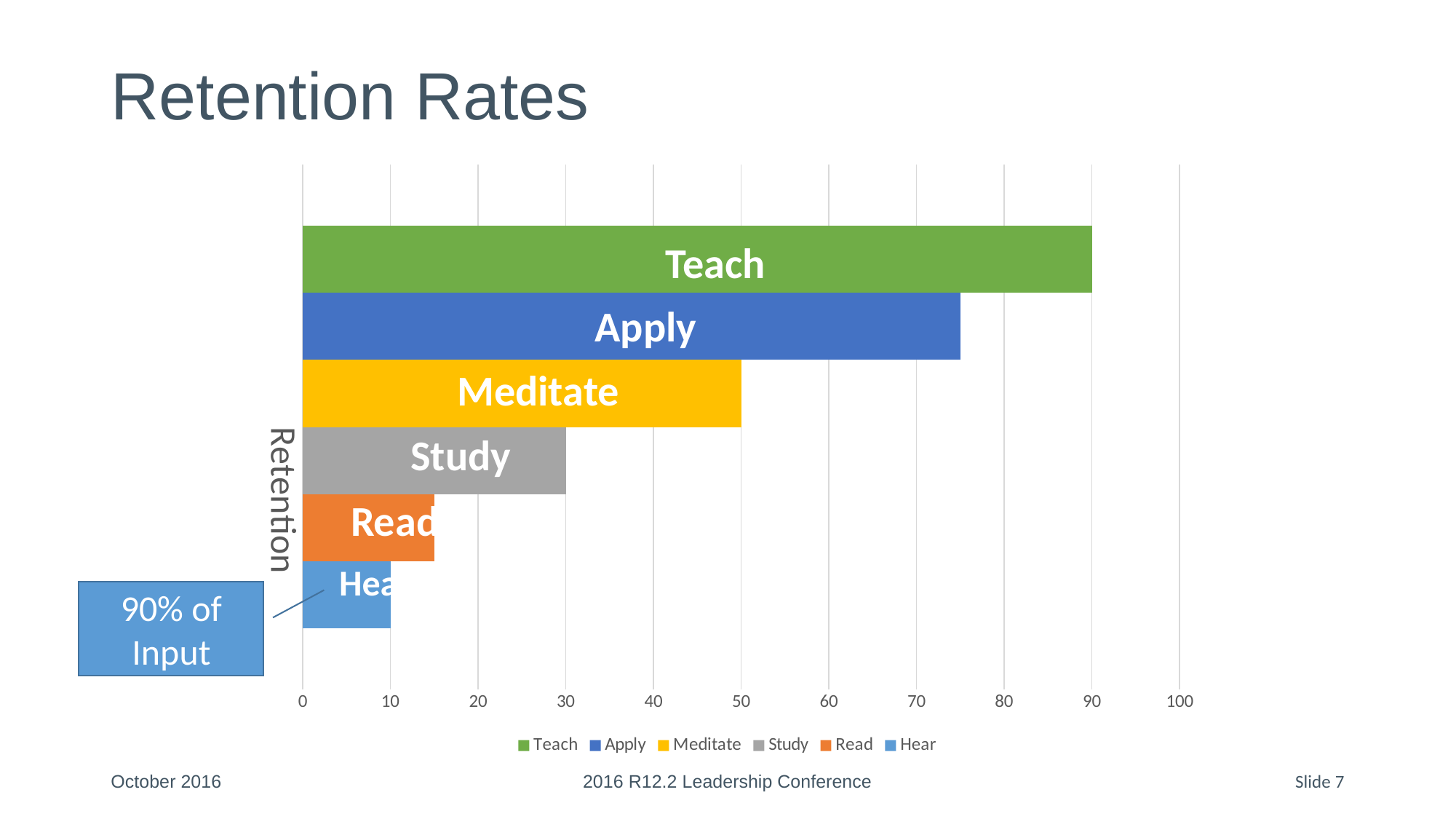
What kind of chart is shown on the slide? bar chart Which category has the highest value? Teach What is the label on the vertical axis of the chart? Retention Is the value for Apply greater or less than 70? greater What is the value for Teach? 90 What is the value for Meditate? 50 What is the difference between the values for Teach and Meditate? 40 How many series does the legend list? 6 What is the value for Study? 30 What is the value for Hear? 10 Is the value for Read greater or less than 20? less Which category has the lowest value? Hear